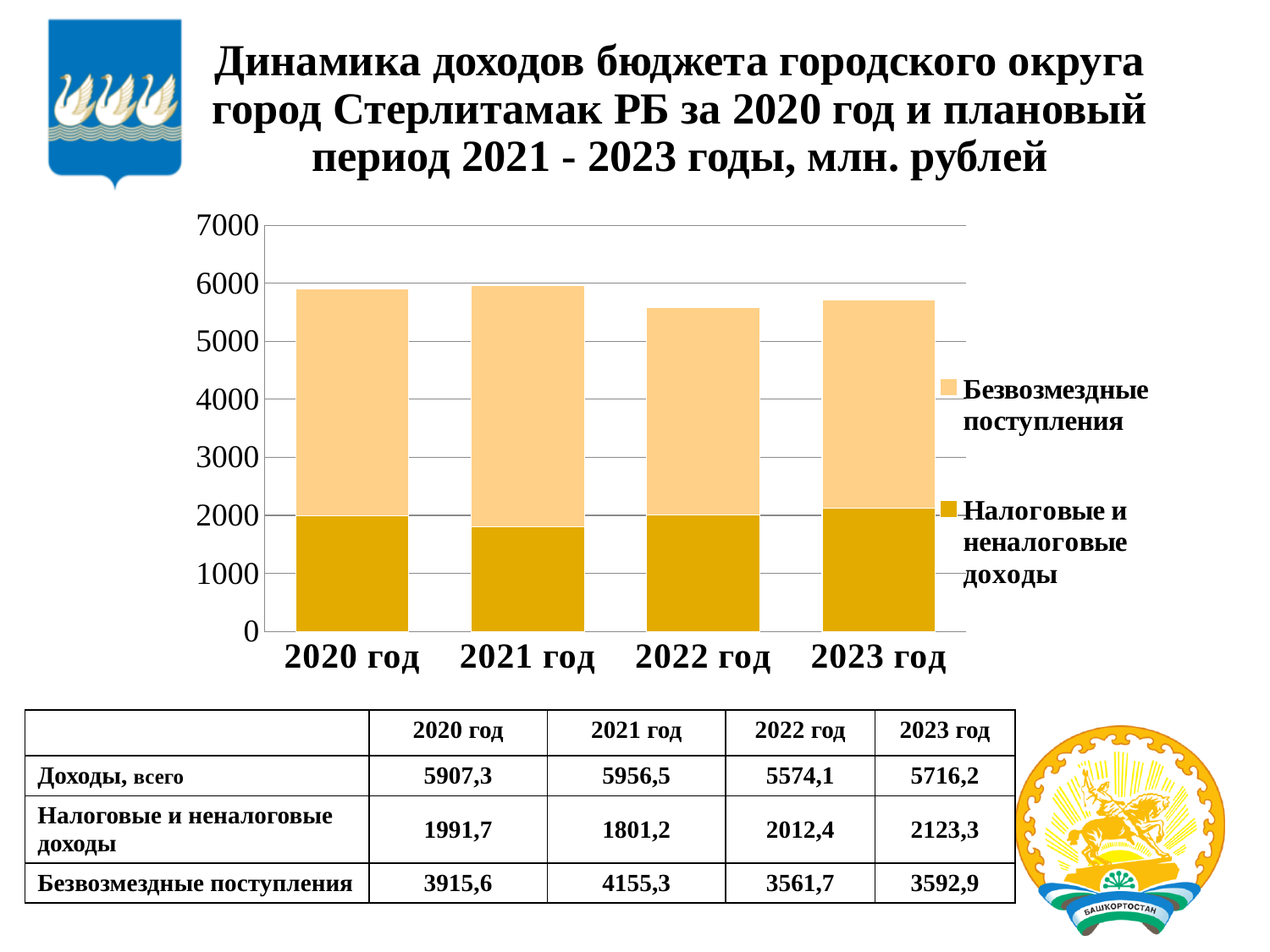
In which year is the total of the stacked bar the lowest? 2022 год What type of chart is shown on the slide? Stacked bar chart Do Налоговые и неналоговые доходы rise or fall from 2021 год to 2023 год? rise Is the value of Налоговые и неналоговые доходы for 2021 год greater or less than 2000? less In which year are Налоговые и неналоговые доходы the highest? 2023 год What is the total income (Доходы, всего) for 2022 год? 5574,1 What is the value of Налоговые и неналоговые доходы for 2020 год? 1991,7 Which is larger: Безвозмездные поступления in 2021 год or in 2022 год? 2021 год How many series does the chart legend list? 2 What is the value of Безвозмездные поступления for 2021 год? 4155,3 How many years (categories) are shown on the x axis of the chart? 4 What is the difference between Налоговые и неналоговые доходы in 2023 год and 2020 год? 131,6